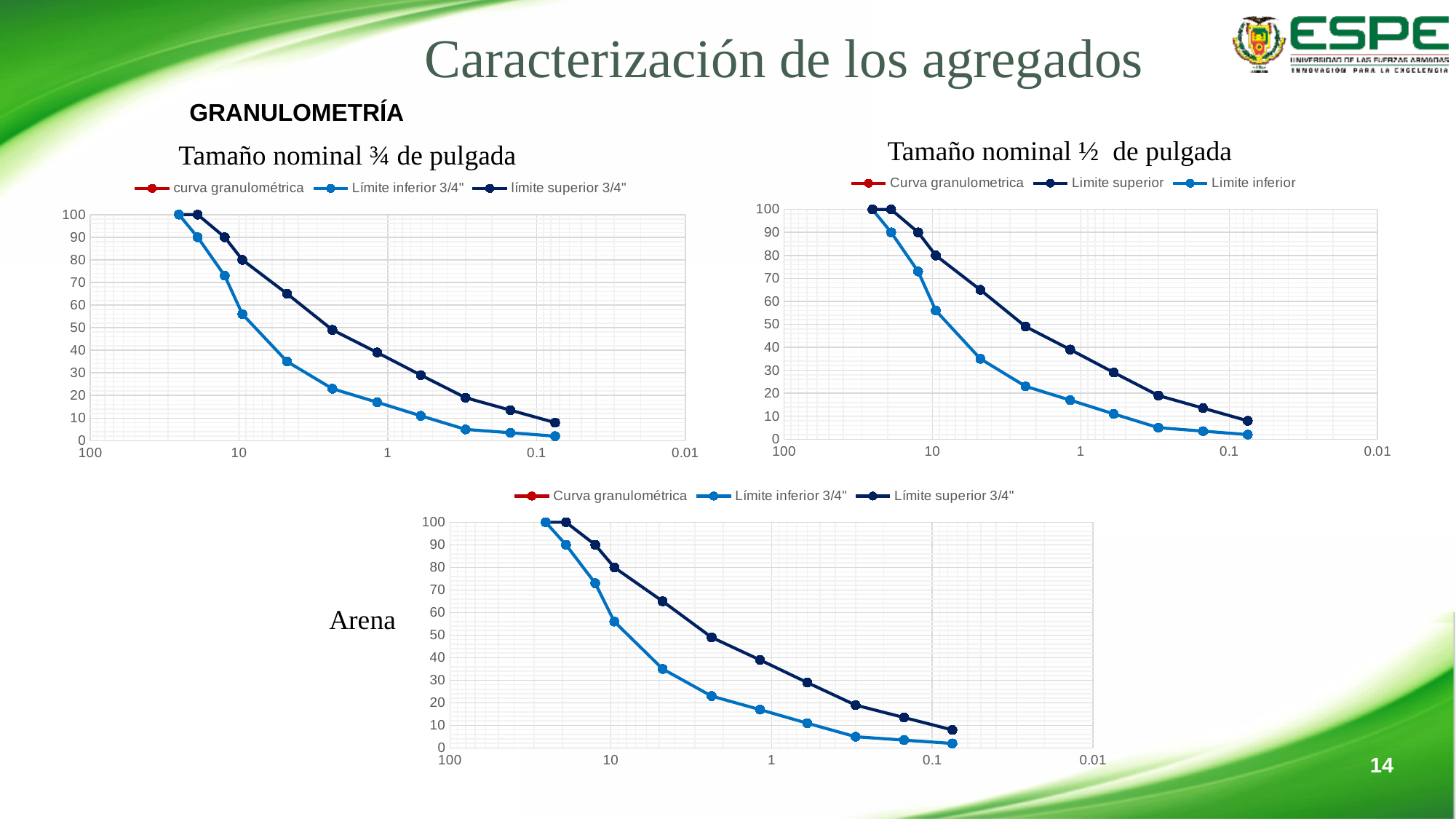
In the 'Tamaño nominal ¾ de pulgada' chart, do the 'límite superior 3/4"' values rise or fall from left to right along the x axis? fall In the 'Tamaño nominal ¾ de pulgada' chart, is the 'límite superior 3/4"' value at x = 1 greater or less than 50? less How many series does the legend of the 'Tamaño nominal ½ de pulgada' chart list? 3 What is the title of the chart at the top right of the slide? Tamaño nominal ½ de pulgada In the 'Arena' chart, do the 'Límite inferior 3/4"' values rise or fall from left to right along the x axis? fall In the 'Tamaño nominal ¾ de pulgada' chart, what colour is the 'curva granulométrica' series in the legend? red What kind of chart is the 'Tamaño nominal ¾ de pulgada' chart? line chart In the 'Arena' chart, is the 'Límite superior 3/4"' value at x = 10 greater or less than 70? greater In the 'Tamaño nominal ¾ de pulgada' chart, is the 'Límite inferior 3/4"' value at x = 10 greater or less than 50? greater In the 'Tamaño nominal ½ de pulgada' chart, at x = 1, which series has the larger value, 'Limite superior' or 'Limite inferior'? Limite superior How many series does the legend of the 'Arena' chart list? 3